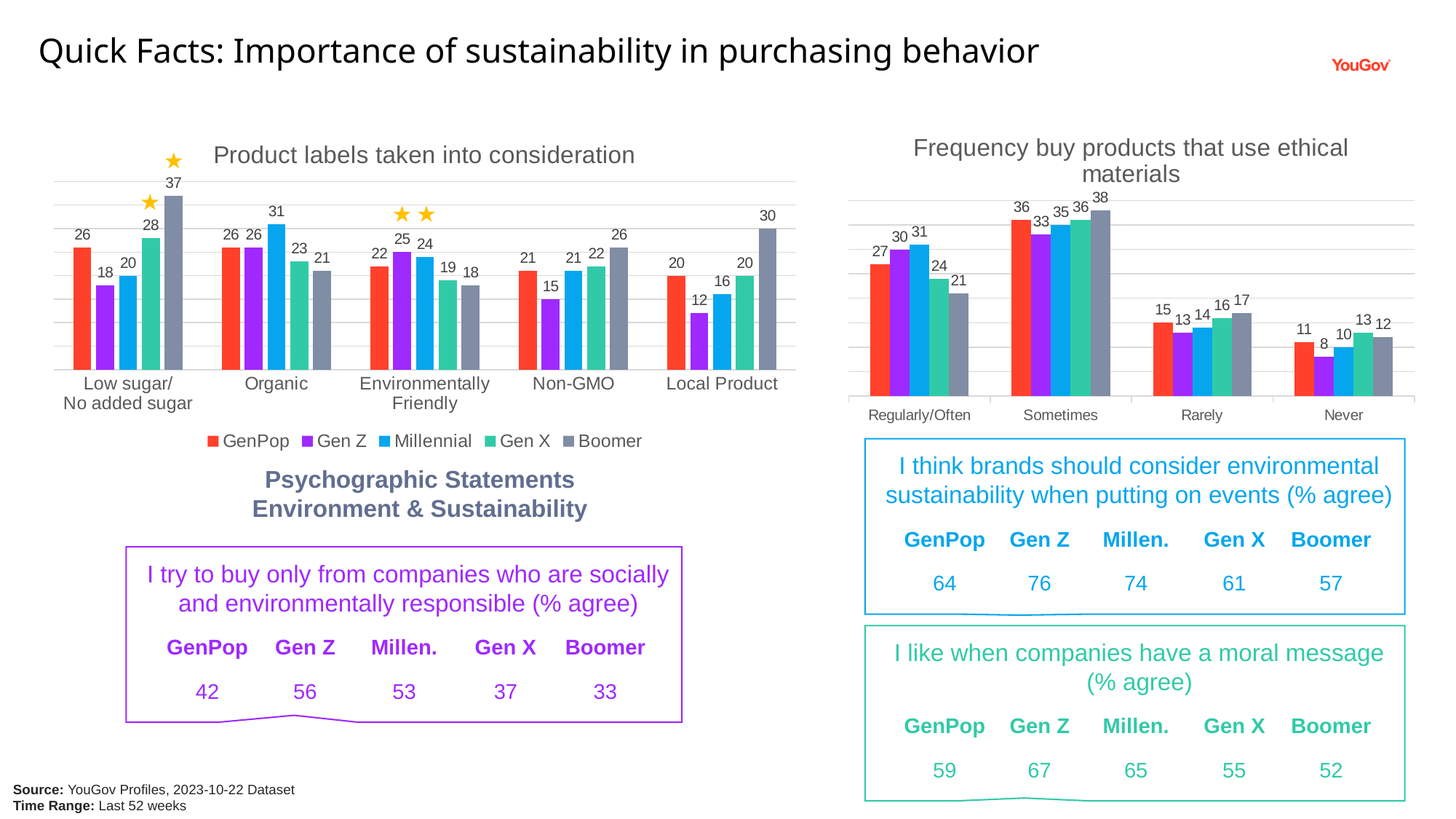
In the 'Frequency buy products that use ethical materials' chart, what is the difference between GenPop in Sometimes and GenPop in Rarely? 21 In the 'Product labels taken into consideration' chart, which colour represents the Gen X series? Teal/green In the 'Frequency buy products that use ethical materials' chart, what is the value for Boomer in the Sometimes category? 38 In the 'Product labels taken into consideration' chart, what is the difference between Boomer and Gen Z in the Low sugar/No added sugar category? 19 In the 'Frequency buy products that use ethical materials' chart, which is larger for Regularly/Often: Gen Z or Gen X? Gen Z In the 'Product labels taken into consideration' chart, what is the value for Millennial in the Organic category? 31 How many series does the legend of the 'Product labels taken into consideration' chart list? 5 What kind of chart is the 'Frequency buy products that use ethical materials' chart? Bar chart In the 'Product labels taken into consideration' chart, what is the value for Boomer in the Low sugar/No added sugar category? 37 In the 'Frequency buy products that use ethical materials' chart, which series has the lowest value in the Never category? Gen Z In the 'Product labels taken into consideration' chart, how many product label categories are shown on the x axis? 5 In the 'Product labels taken into consideration' chart, which series has the lowest value in the Local Product category? Gen Z